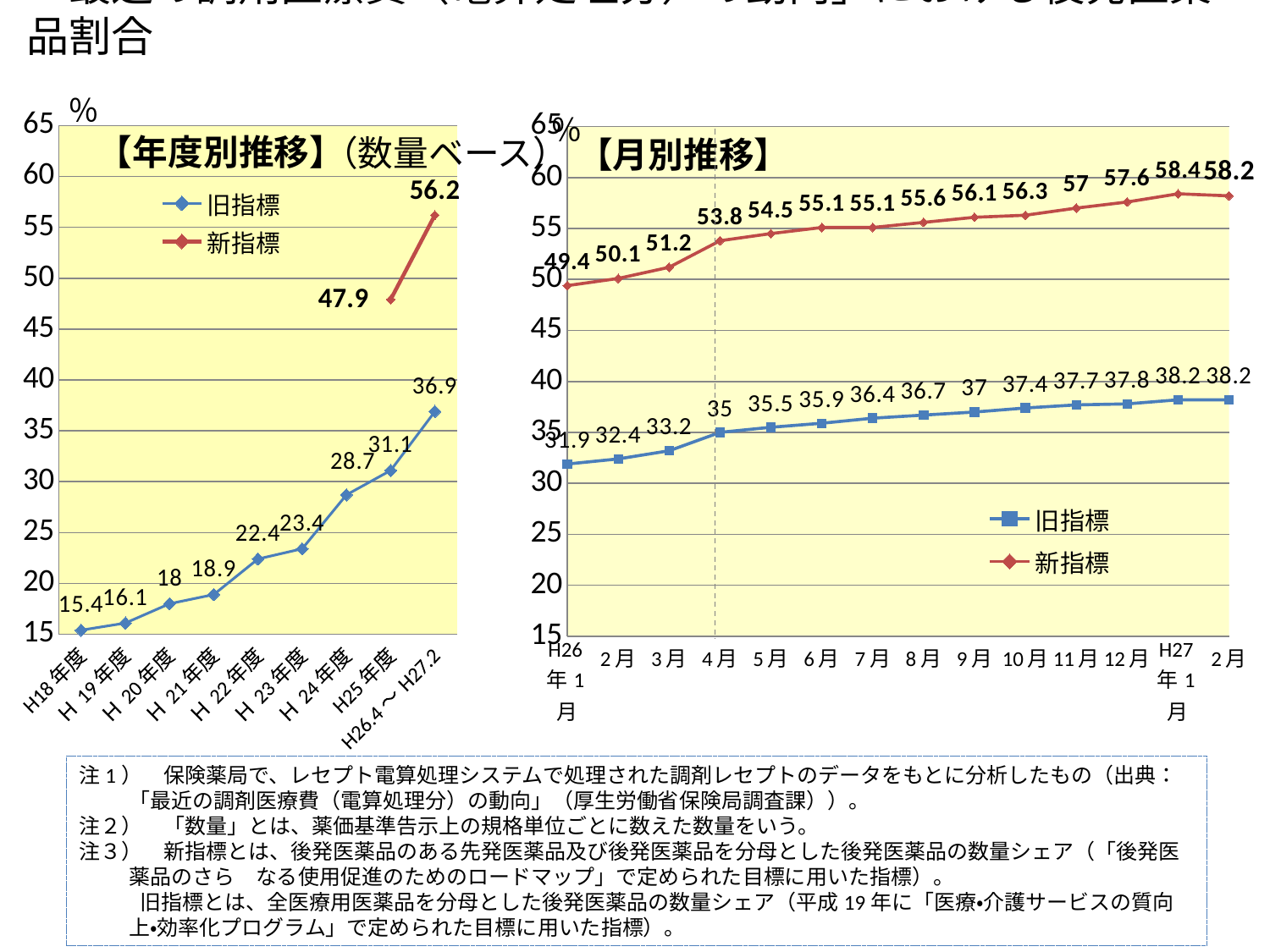
In the 【月別推移】 chart on the right, what is the 旧指標 value for 9月? 37 What kind of chart is the 【月別推移】 chart on the right? line chart In the 【年度別推移】 chart on the left, what is the 新指標 value for H26.4～H27.2? 56.2 In the 【年度別推移】 chart on the left, does the 旧指標 series rise or fall from H18年度 to H26.4～H27.2? rise In the 【月別推移】 chart on the right, which month has the highest 新指標 value? H27年1月 In the 【年度別推移】 chart on the left, what is the 旧指標 value for H18年度? 15.4 In the 【月別推移】 chart on the right, what is the 新指標 value for 4月 of H26? 53.8 How many series does the legend of the 【月別推移】 chart on the right list? 2 In the 【月別推移】 chart on the right, which month has the lowest 旧指標 value? H26年1月 In the 【年度別推移】 chart on the left, what is the difference between the 新指標 and 旧指標 values for H25年度? 16.8 In the 【月別推移】 chart on the right, what is the difference between the 新指標 values for H27年1月 and H26年1月? 9 In the 【年度別推移】 chart on the left, how many categories are shown on the x axis? 9